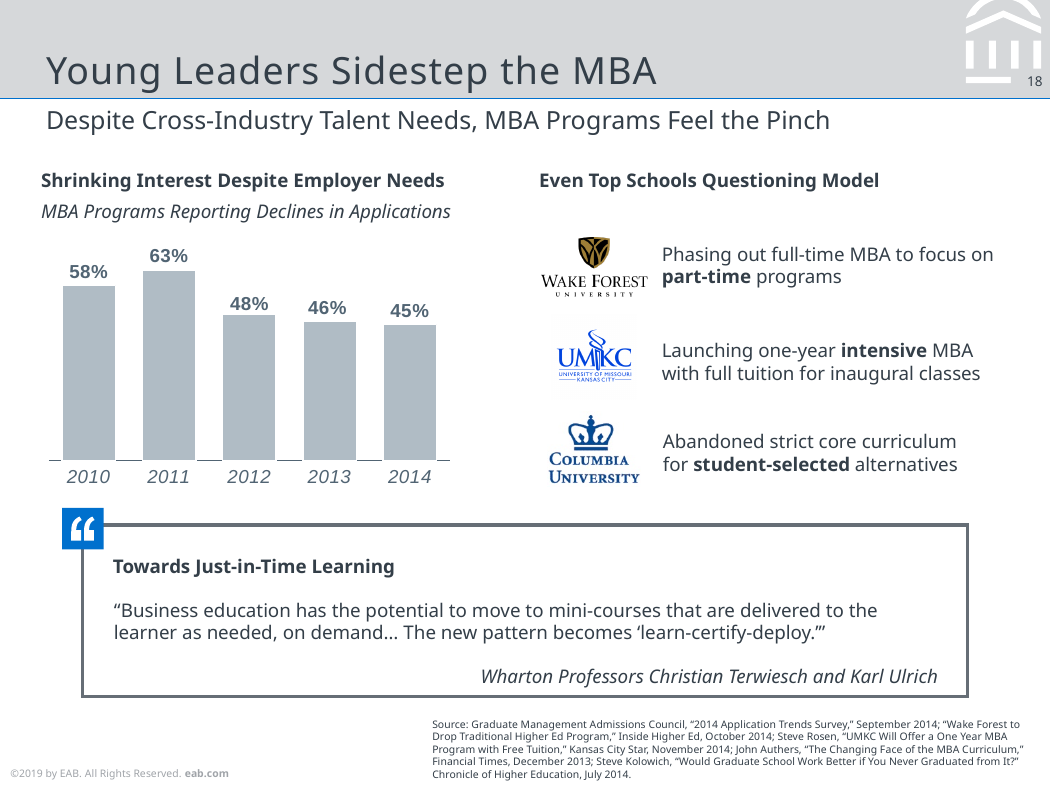
What is the subtitle of the chart on the left side of the slide? MBA Programs Reporting Declines in Applications Which year has the lowest share of MBA programs reporting declines in applications? 2014 What percentage of MBA programs reported declines in applications in 2011? 63% What is the value shown for 2014 in the chart of MBA programs reporting declines in applications? 45% What is the difference in percentage points between the 2011 and 2014 values? 18 What is the value shown for 2010 in the chart? 58% Which year has a larger value, 2012 or 2013? 2012 What kind of chart is used to show MBA programs reporting declines in applications? Bar chart From 2011 to 2014, do the values in the chart rise or fall? Fall Which year has the highest share of MBA programs reporting declines in applications? 2011 How many years are shown in the chart? 5 What is the difference in percentage points between the 2010 and 2012 values? 10